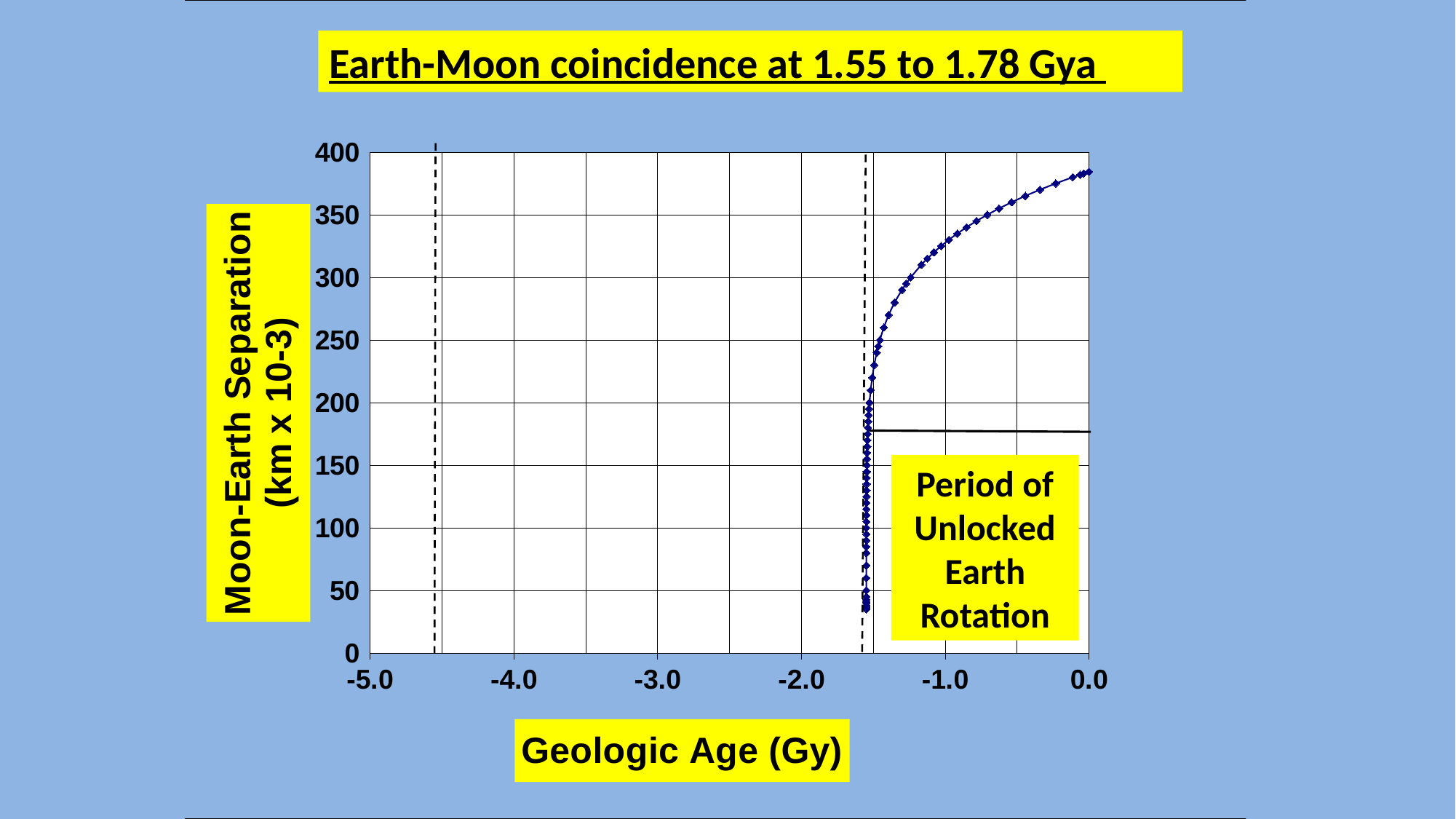
Is the Moon-Earth separation at geologic age -1.0 Gy greater or less than 350? less Which is larger, the Moon-Earth separation at -1.0 Gy or at 0.0 Gy? 0.0 Gy What is the title of the chart? Earth-Moon coincidence at 1.55 to 1.78 Gya Does the Moon-Earth separation rise or fall as geologic age moves from -1.5 toward 0.0 Gy? Rise Is the Moon-Earth separation at geologic age -1.0 Gy greater or less than 300? greater How many labelled tick marks are on the x axis? 6 Is the Moon-Earth separation at geologic age -0.5 Gy greater or less than 400? less What kind of chart is shown on the slide? Line chart What is the label of the y axis? Moon-Earth Separation (km x 10-3) What is the maximum value shown on the y axis? 400